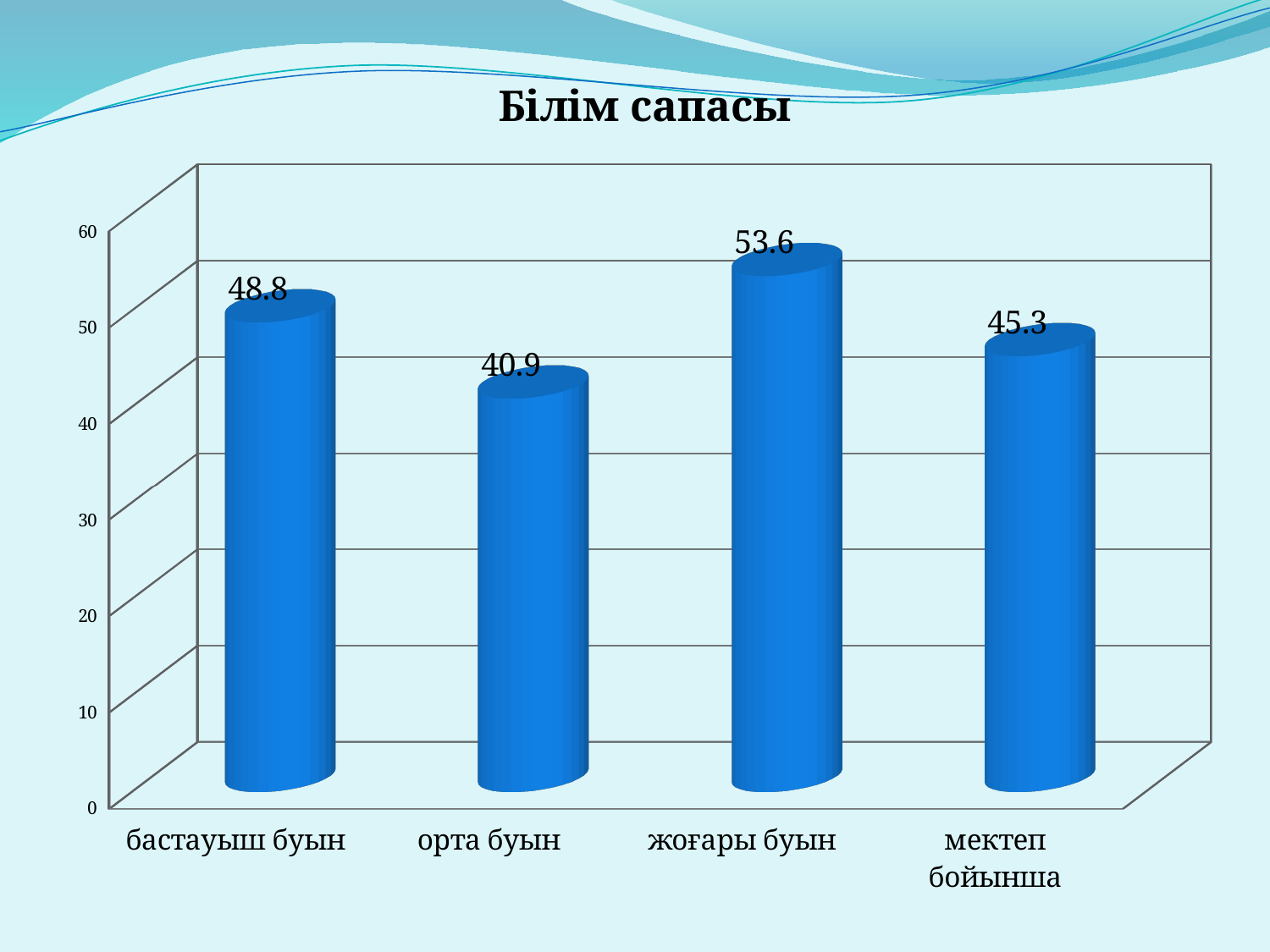
Is the value for орта буын greater or less than 50? less What is the value for орта буын? 40.9 Which is larger, the value for бастауыш буын or the value for мектеп бойынша? бастауыш буын What is the difference between the values for жоғары буын and орта буын? 12.7 What is the value for бастауыш буын? 48.8 How many categories are shown on the chart? 4 Which category has the highest value? жоғары буын What is the value for жоғары буын? 53.6 What is the value for мектеп бойынша? 45.3 What is the difference between the values for бастауыш буын and мектеп бойынша? 3.5 What is the title of the chart? Білім сапасы Which category has the lowest value? орта буын